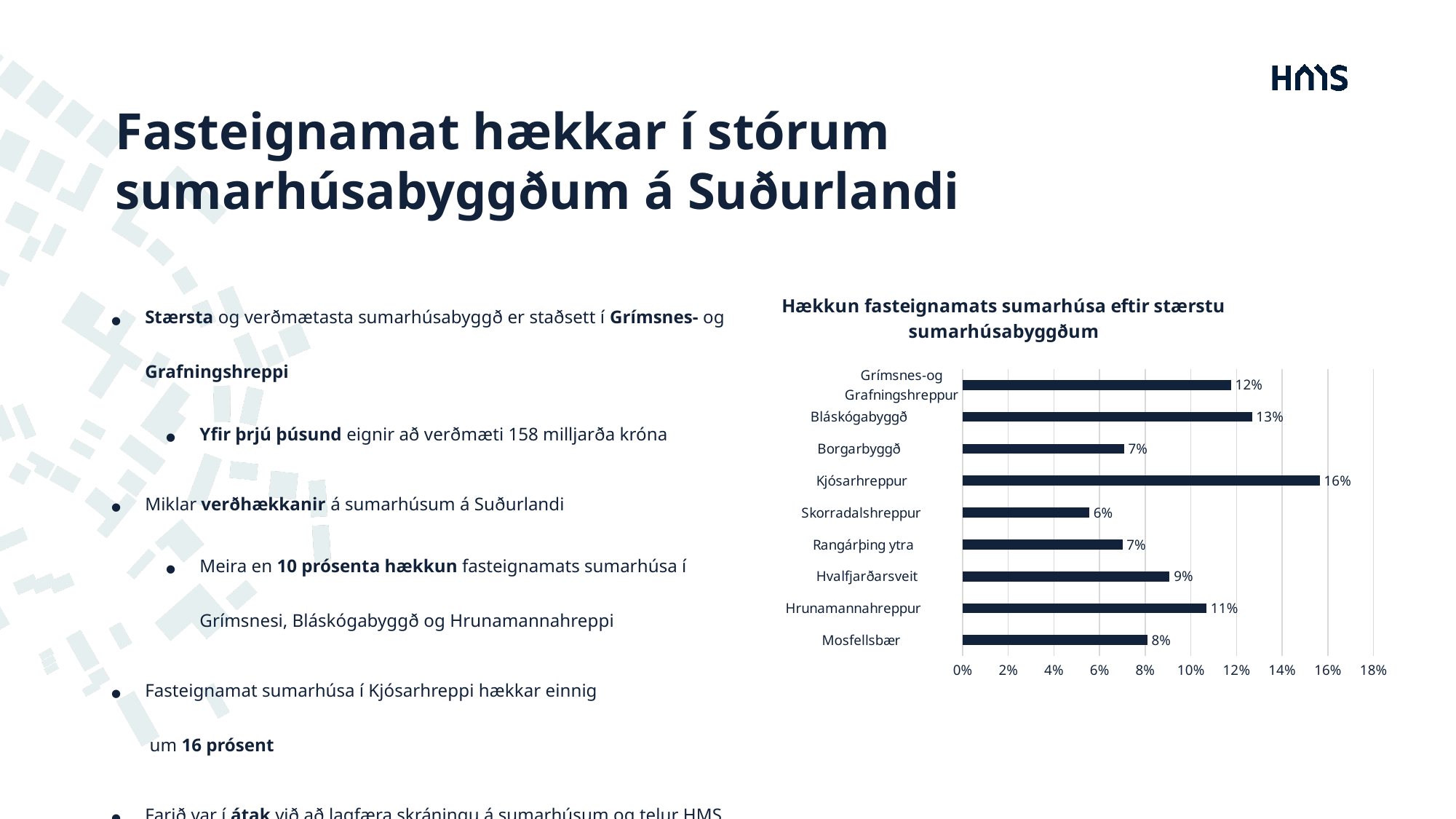
What is the value for Bláskógabyggð? 13% Which category has the highest value? Kjósarhreppur What is the title of the chart? Hækkun fasteignamats sumarhúsa eftir stærstu sumarhúsabyggðum Is the value for Hvalfjarðarsveit greater or less than 10%? less What is the difference between the values for Kjósarhreppur and Skorradalshreppur? 10% What is the value for Hrunamannahreppur? 11% Which category has the lowest value? Skorradalshreppur What is the value for Mosfellsbær? 8% How many categories are shown in the chart? 9 What is the value for Kjósarhreppur? 16% Which is larger, the value for Bláskógabyggð or the value for Grímsnes-og Grafningshreppur? Bláskógabyggð What kind of chart is shown on the slide? bar chart